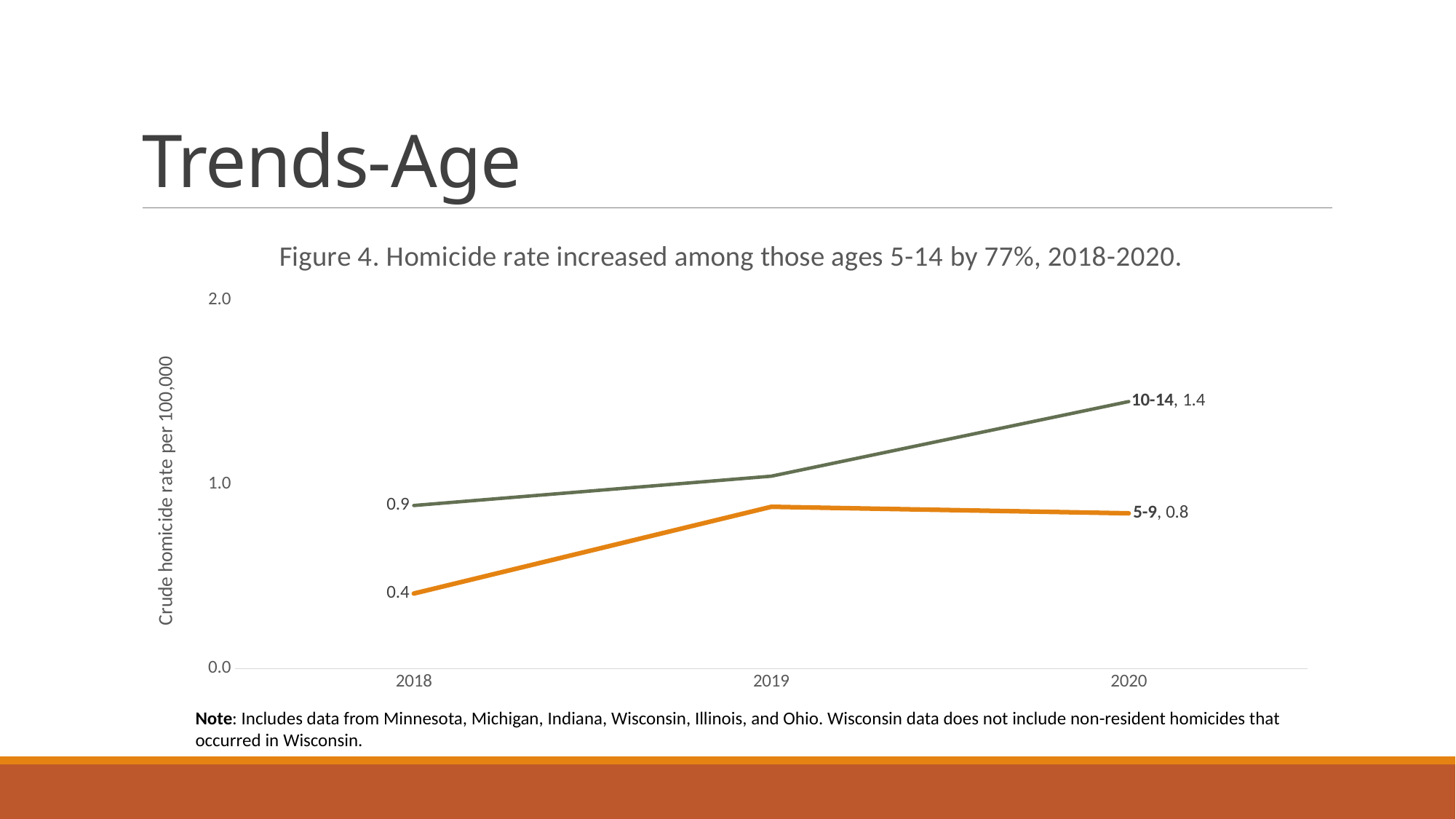
Which age group had the higher crude homicide rate in 2018, 10-14 or 5-9? 10-14 What is the crude homicide rate for ages 5-9 in 2020? 0.8 What is the crude homicide rate for ages 5-9 in 2018? 0.4 How many years are shown on the x axis? 3 How many age-group series are plotted on the chart? 2 Does the crude homicide rate for ages 10-14 rise or fall from 2018 to 2020? rise What is the crude homicide rate for ages 10-14 in 2018? 0.9 What is the difference between the 10-14 and 5-9 rates in 2020? 0.6 How much did the crude homicide rate for ages 10-14 increase from 2018 to 2020? 0.5 What is the crude homicide rate for ages 10-14 in 2020? 1.4 What type of chart is shown on the slide? line chart